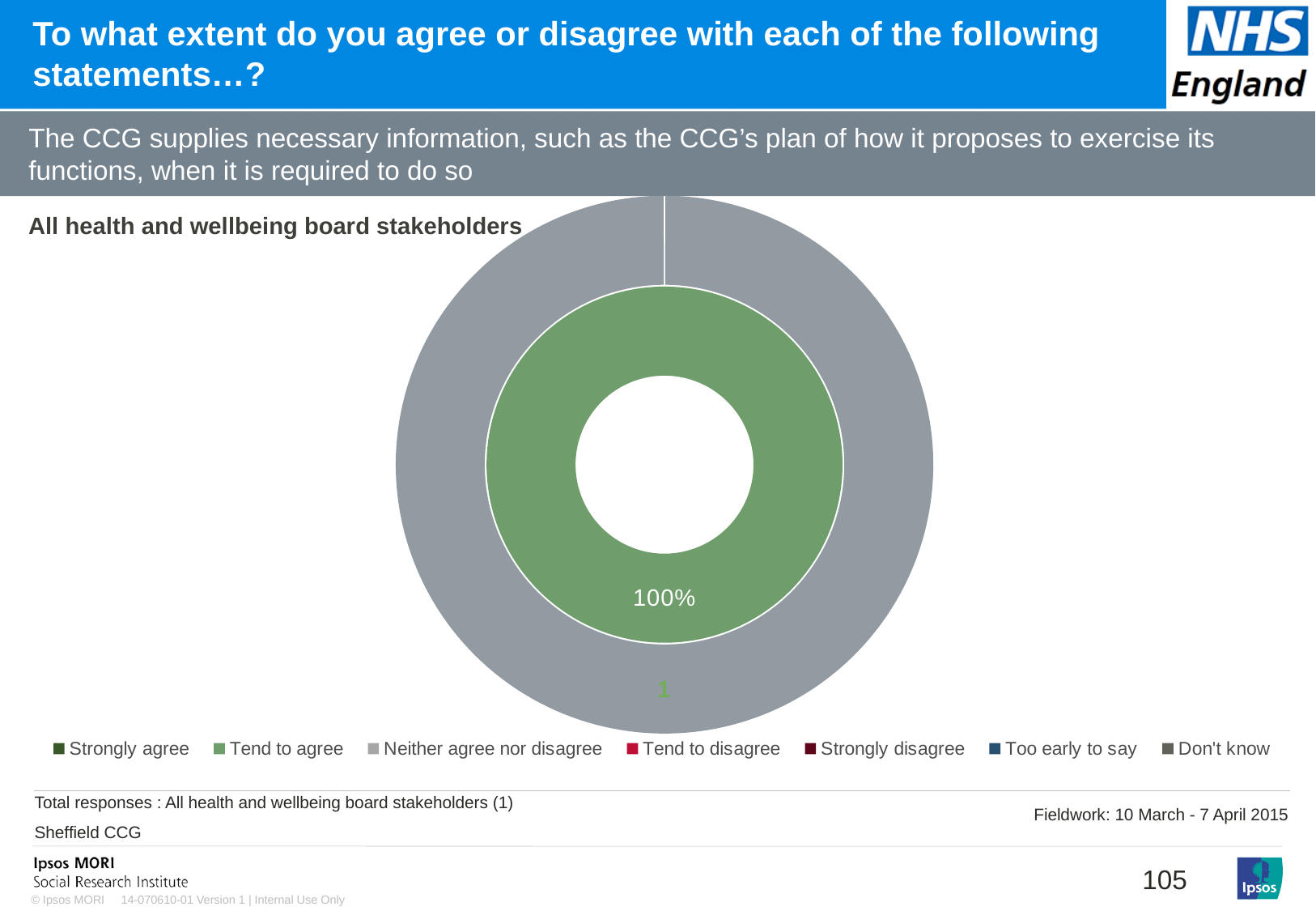
How many percentage data labels are printed on the chart? 1 What share of responses does the 'Tend to agree' category account for? 100% How many response categories does the legend list? 7 What percentage value is printed on the green segment of the chart? 100% What is the subtitle printed above the chart describing the respondent group? All health and wellbeing board stakeholders Which response category makes up the whole of the inner ring? Tend to agree What kind of chart is shown on the slide? doughnut chart Which category is listed first in the chart legend? Strongly agree